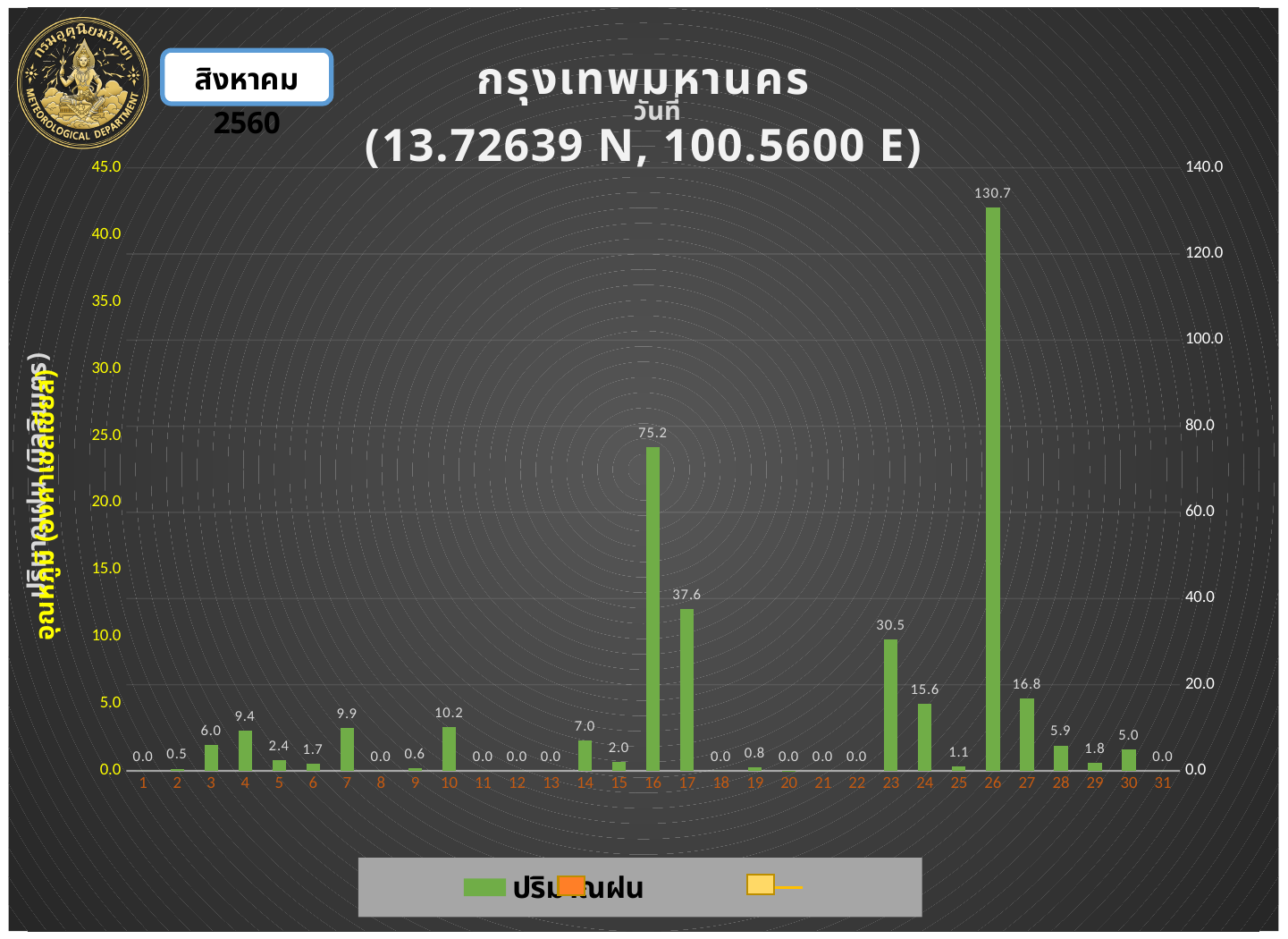
What is the value for day 23? 30.5 What is the difference between the values for day 17 and day 23? 7.1 Which day has the highest value? 26 Which is larger, the value for day 4 or the value for day 7? day 7 What is the value for day 26? 130.7 Which is larger, the value for day 24 or the value for day 27? day 27 What is the value for day 16? 75.2 What kind of chart is shown on the slide? bar chart What is the value for day 10? 10.2 What is the difference between the values for day 26 and day 16? 55.5 What coordinates are given in the chart title? 13.72639 N, 100.5600 E How many days are shown on the x axis? 31